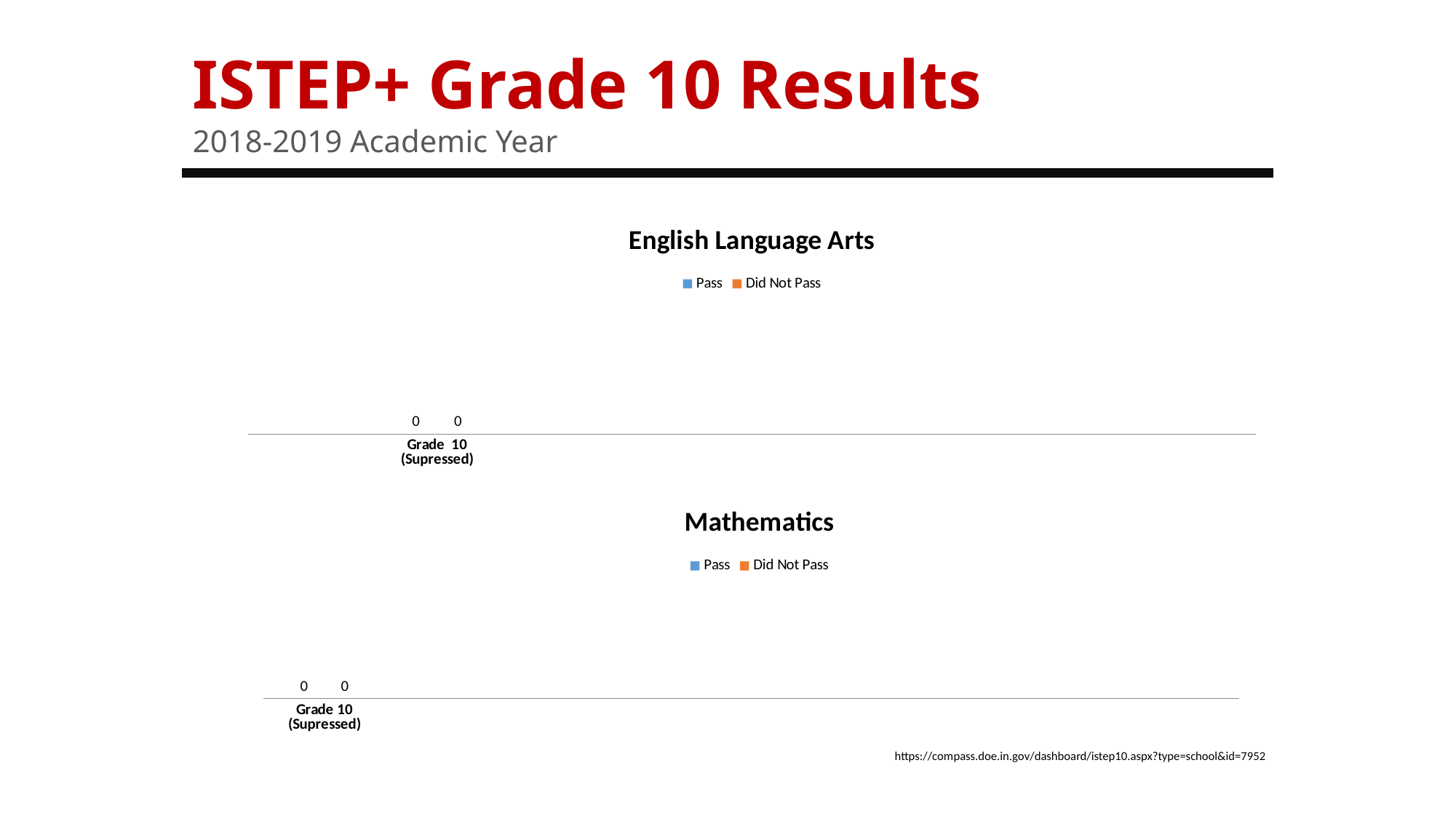
In the Mathematics chart, what is the value for Did Not Pass for Grade 10 (Supressed)? 0 In the Mathematics chart, what is the difference between the Pass and Did Not Pass values for Grade 10 (Supressed)? 0 In the English Language Arts chart, what is the combined total of Pass and Did Not Pass for Grade 10 (Supressed)? 0 How many categories are shown on the x axis of the English Language Arts chart? 1 How many categories are shown on the x axis of the Mathematics chart? 1 What are the two legend entries in the Mathematics chart? Pass and Did Not Pass How many series does the legend of the English Language Arts chart list? 2 How many series does the legend of the Mathematics chart list? 2 What is the title of the upper chart on the slide? English Language Arts In the English Language Arts chart, what is the value for Pass for Grade 10 (Supressed)? 0 In the English Language Arts chart, what is the value for Did Not Pass for Grade 10 (Supressed)? 0 In the Mathematics chart, what is the value for Pass for Grade 10 (Supressed)? 0